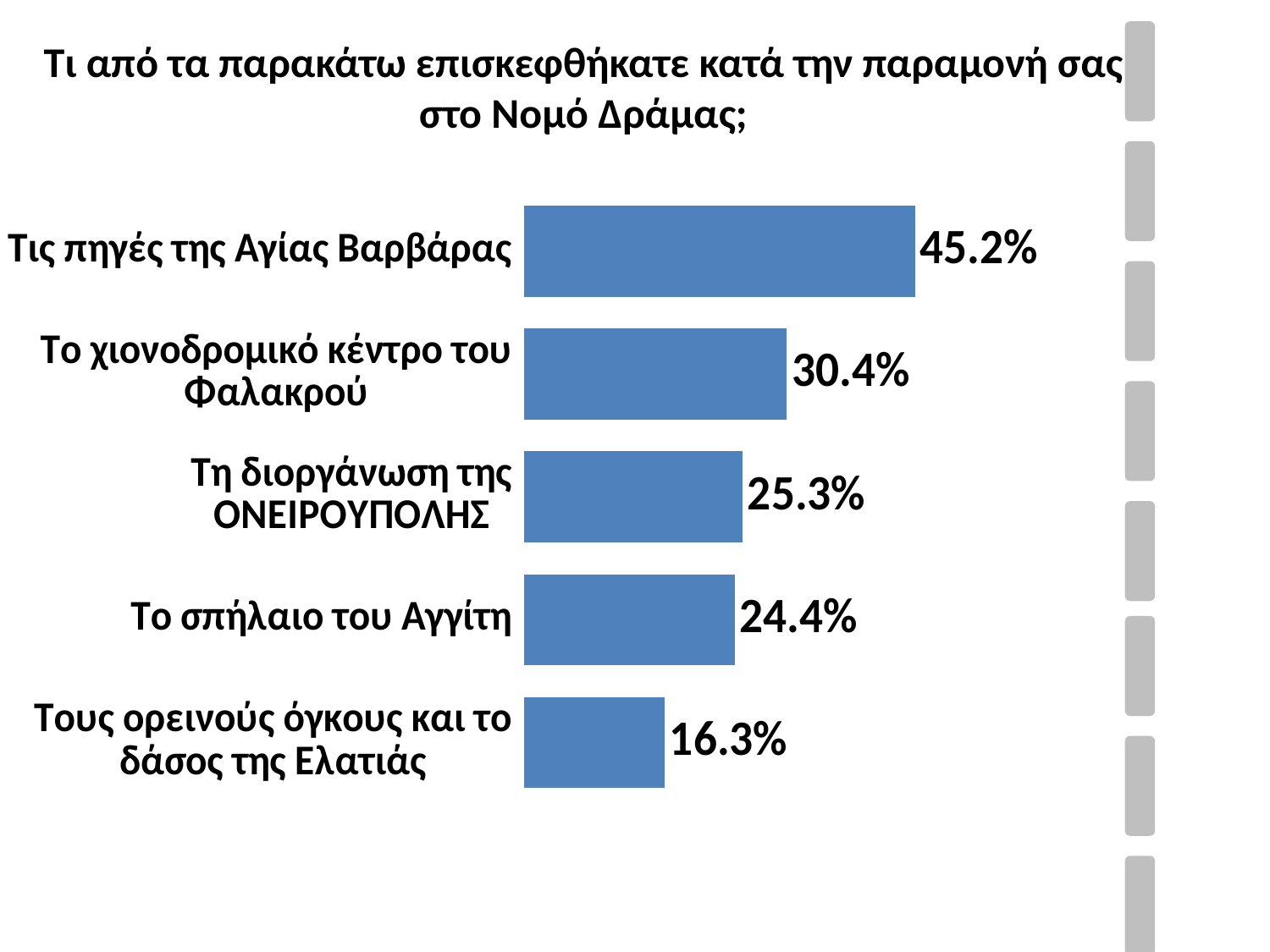
Which category has the lowest value? Τους ορεινούς όγκους και το δάσος της Ελατιάς What is the difference between the values for Τη διοργάνωση της ΟΝΕΙΡΟΥΠΟΛΗΣ and Το σπήλαιο του Αγγίτη? 0.9% What is the title of the chart? Τι από τα παρακάτω επισκεφθήκατε κατά την παραμονή σας στο Νομό Δράμας; What is the difference between the values for Τις πηγές της Αγίας Βαρβάρας and Το χιονοδρομικό κέντρο του Φαλακρού? 14.8% How many categories are shown in the chart? 5 Which category has the highest value? Τις πηγές της Αγίας Βαρβάρας What kind of chart is shown on the slide? Bar chart What is the value shown for Το σπήλαιο του Αγγίτη? 24.4% What is the value shown for Τους ορεινούς όγκους και το δάσος της Ελατιάς? 16.3% Which has a larger value, Το χιονοδρομικό κέντρο του Φαλακρού or Τη διοργάνωση της ΟΝΕΙΡΟΥΠΟΛΗΣ? Το χιονοδρομικό κέντρο του Φαλακρού What percentage of respondents visited Τις πηγές της Αγίας Βαρβάρας? 45.2% What is the value shown for Το χιονοδρομικό κέντρο του Φαλακρού? 30.4%